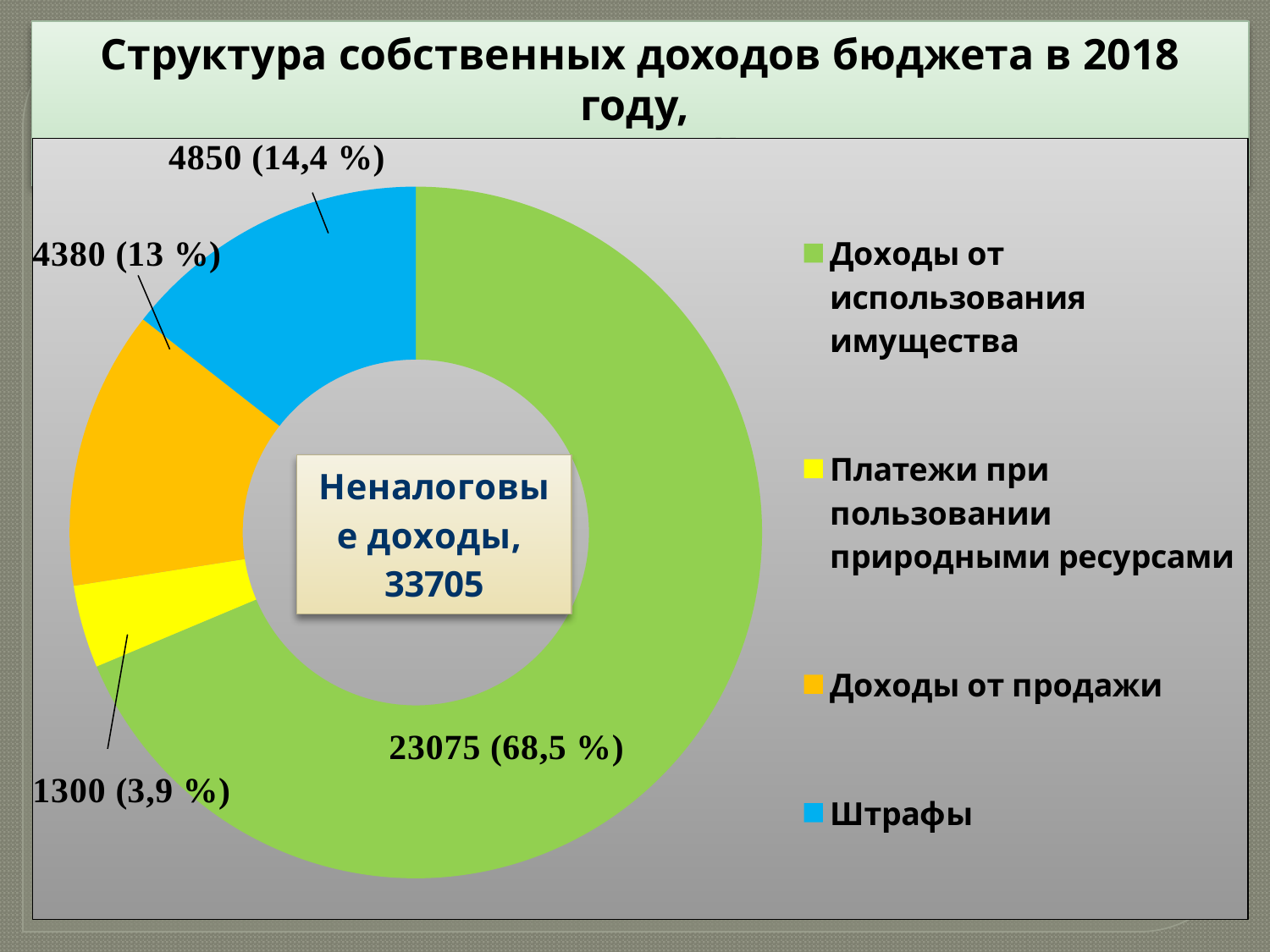
What kind of chart is shown on the slide? Doughnut (pie) chart Which colour represents Штрафы in the chart? Blue What is the value for Доходы от продажи? 4380 What is the value for Доходы от использования имущества? 23075 Which category has the largest value? Доходы от использования имущества Which category has the smallest value? Платежи при пользовании природными ресурсами Which is larger: the value for Штрафы or the value for Доходы от продажи? Штрафы What share of the chart does Штрафы represent? 14,4 % How many categories does the chart show? 4 What share of the chart does Платежи при пользовании природными ресурсами represent? 3,9 % What total value is shown in the centre of the chart? 33705 What is the difference between the values for Штрафы and Доходы от продажи? 470